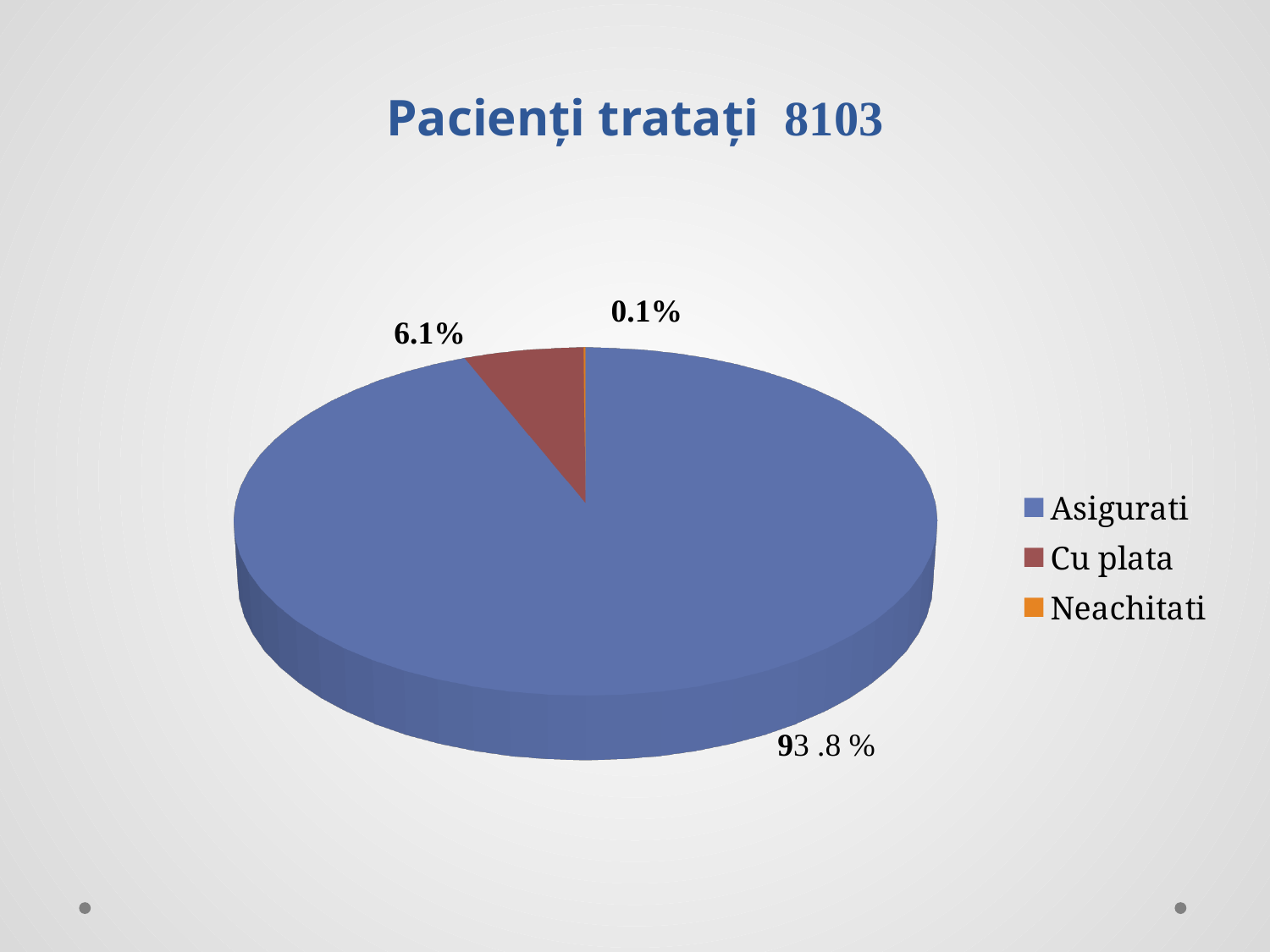
What colour is the Cu plata slice in the pie chart? red Which category has the largest slice of the pie? Asigurati What share of the pie does Asigurati represent? 93.8% What is the title of the chart? Pacienți tratați 8103 What kind of chart is shown on the slide? pie chart How many entries does the legend list? 3 Which category has the smallest slice of the pie? Neachitati Which is larger, the share for Cu plata or the share for Neachitati? Cu plata How many slices does the pie chart have? 3 What is the value shown for Cu plata? 6.1% What is the value shown for Neachitati? 0.1% What is the difference between the Asigurati share and the Cu plata share? 87.7%